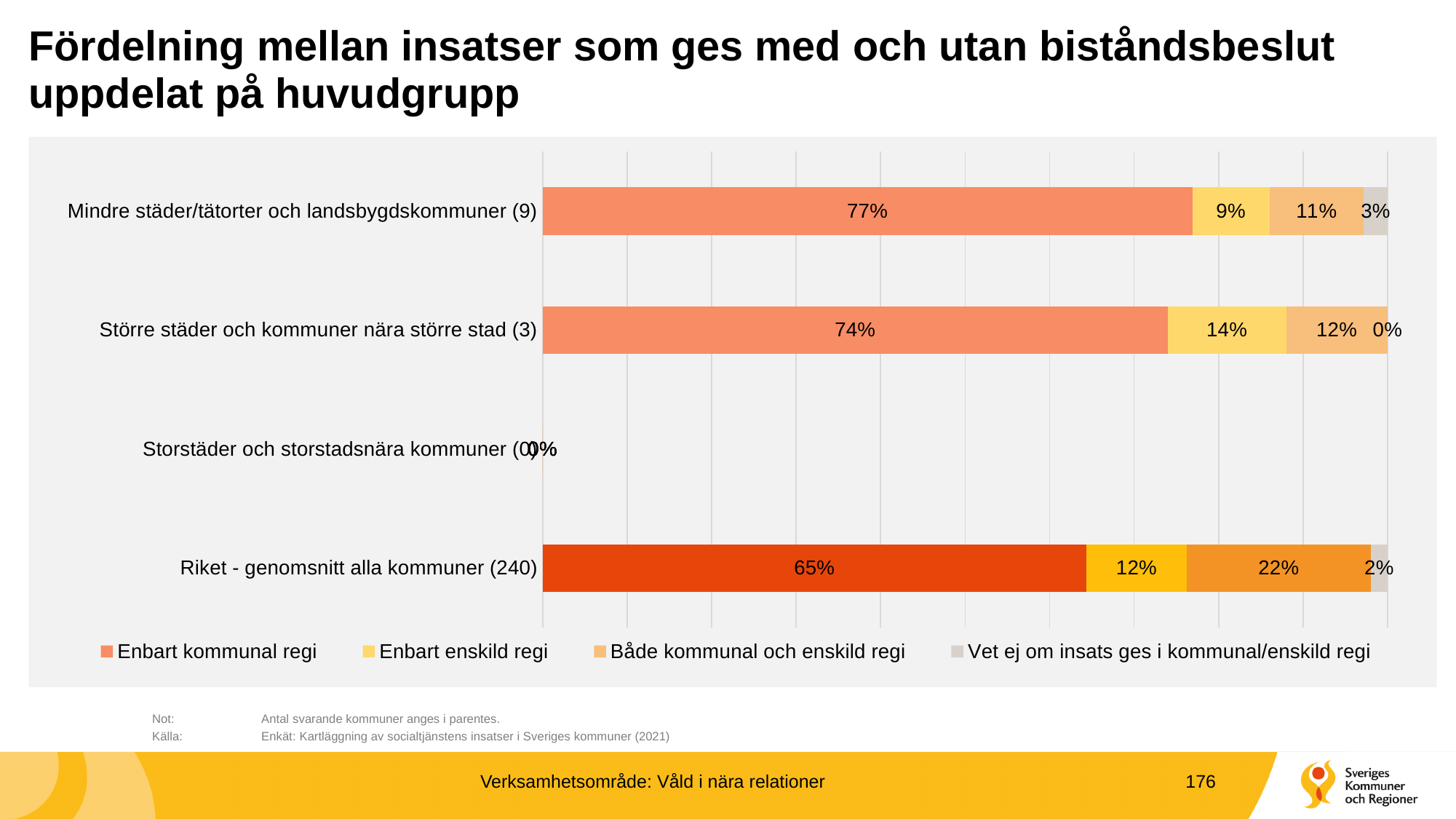
What is the value for 'Enbart kommunal regi' for 'Mindre städer/tätorter och landsbygdskommuner (9)'? 77% How many series does the legend list? 4 What kind of chart is shown on the slide? stacked bar chart Which is larger: the 'Enbart enskild regi' value for 'Större städer och kommuner nära större stad (3)' or for 'Mindre städer/tätorter och landsbygdskommuner (9)'? Större städer och kommuner nära större stad (3) Which category has the highest value for 'Både kommunal och enskild regi'? Riket - genomsnitt alla kommuner (240) What is the value for 'Både kommunal och enskild regi' for 'Riket - genomsnitt alla kommuner (240)'? 22% What is the first legend entry of the chart? Enbart kommunal regi What is the value for 'Enbart enskild regi' for 'Större städer och kommuner nära större stad (3)'? 14% What is the difference between the 'Enbart kommunal regi' values for 'Mindre städer/tätorter och landsbygdskommuner (9)' and 'Riket - genomsnitt alla kommuner (240)'? 12 percentage points What is the value for 'Vet ej om insats ges i kommunal/enskild regi' for 'Större städer och kommuner nära större stad (3)'? 0% How many categories are shown on the chart? 4 Which category has the highest value for 'Enbart kommunal regi'? Mindre städer/tätorter och landsbygdskommuner (9)